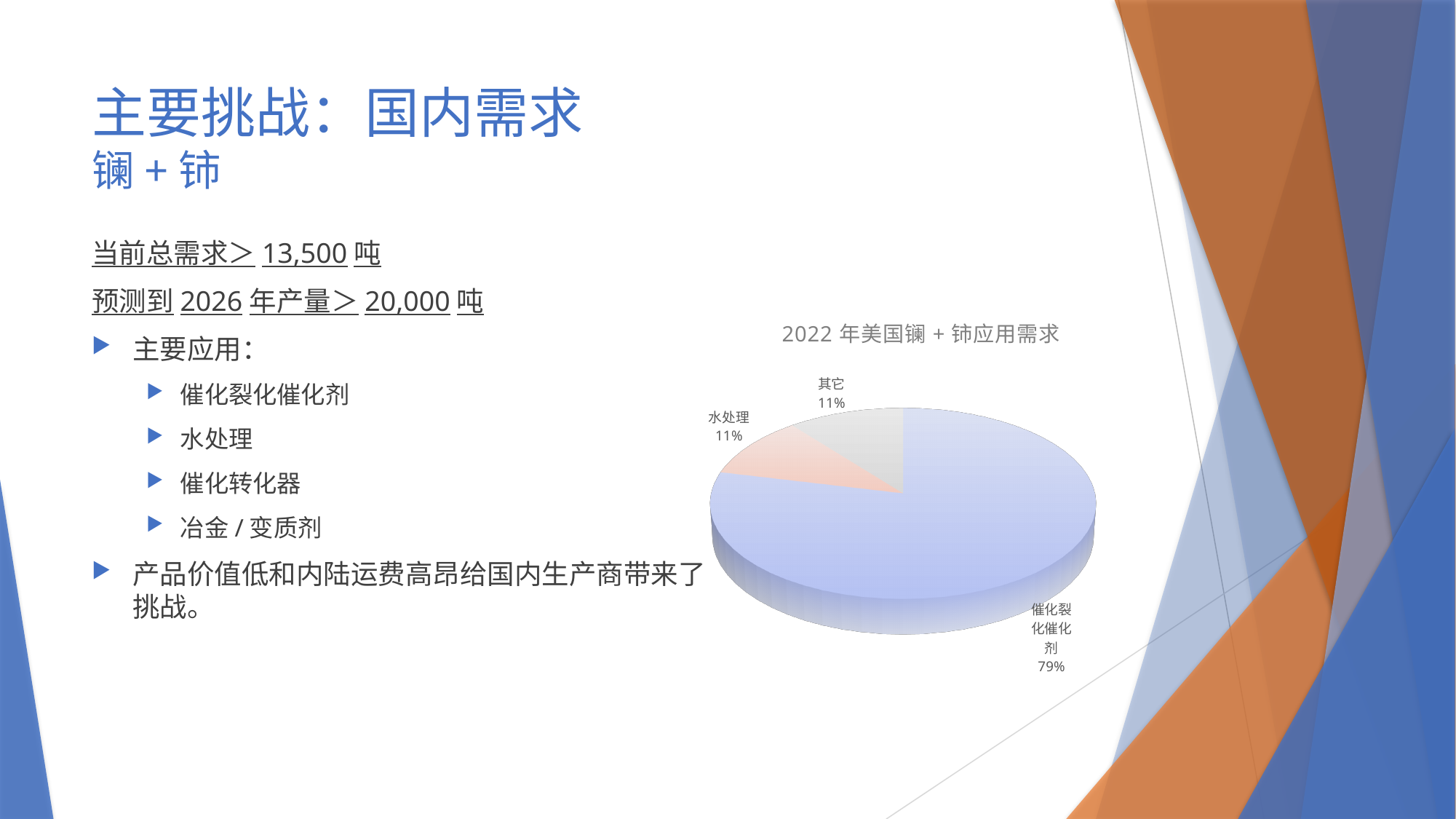
Which is larger, the share for 催化裂化催化剂 or the share for 水处理? 催化裂化催化剂 What kind of chart is shown on the slide? Pie chart Which category has the largest slice of the pie? 催化裂化催化剂 How many slices does the pie chart have? 3 Is the share for 催化裂化催化剂 greater or less than 50%? greater What percentage is shown for 其它? 11% What is the title of the pie chart? 2022 年美国镧 + 铈应用需求 By how many percentage points does the 催化裂化催化剂 share exceed the 其它 share? 68 percentage points What percentage is shown for 水处理? 11% What colour is the 催化裂化催化剂 slice? Blue What share of the pie does 催化裂化催化剂 account for? 79%